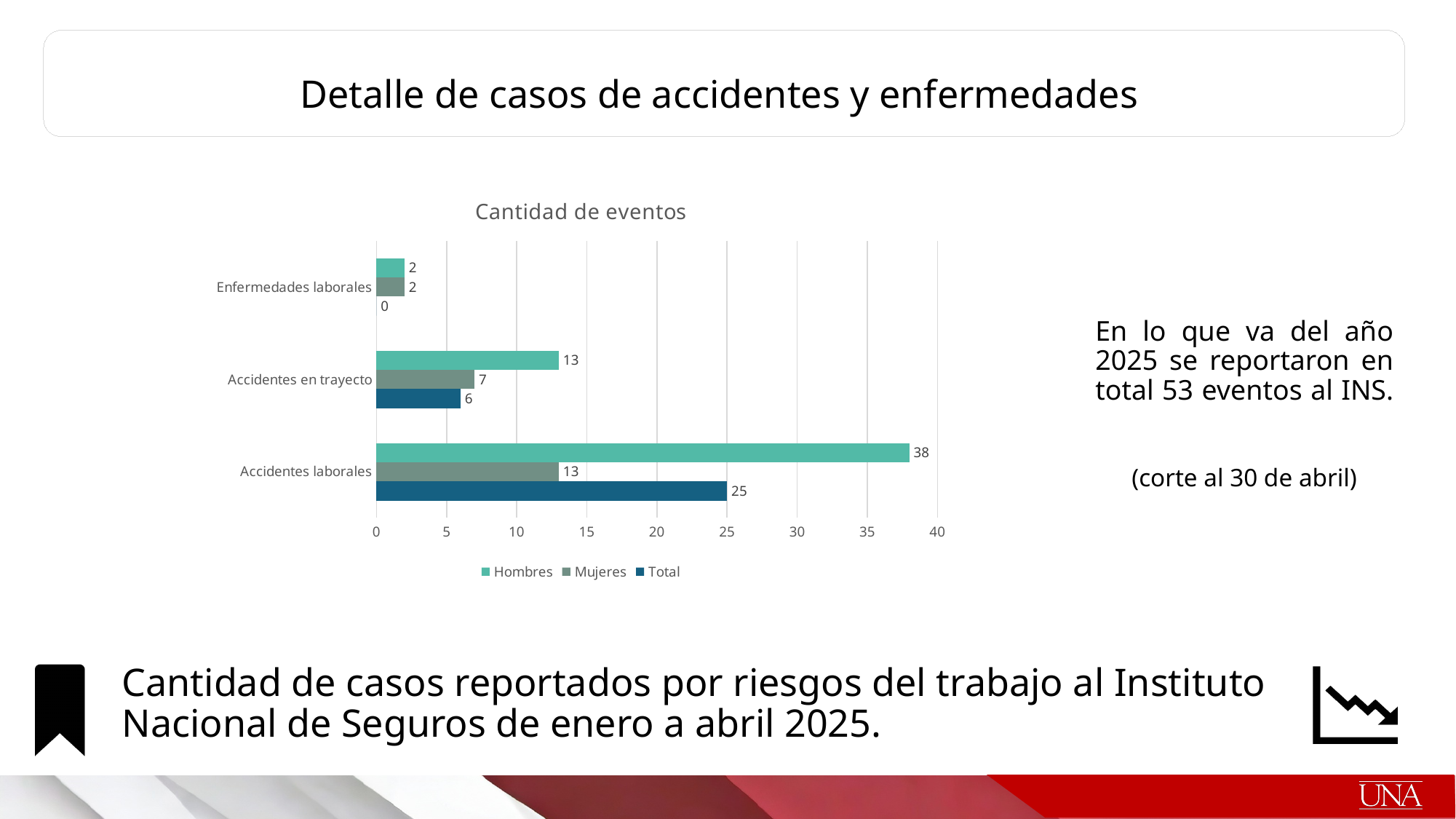
Which category has the highest Hombres value? Accidentes laborales What is the value for Hombres in the Accidentes laborales category? 38 How many categories are shown on the chart? 3 What is the value for Total in the Accidentes laborales category? 25 What is the difference between the Hombres and Mujeres values for Accidentes laborales? 25 How many series does the legend list? 3 What kind of chart is shown on the slide? Bar chart What is the value for Mujeres in the Accidentes en trayecto category? 7 Which is larger for Accidentes en trayecto, the Hombres value or the Total value? Hombres Which category has the lowest Total value? Enfermedades laborales What is the value for Total in the Enfermedades laborales category? 0 What is the title of the chart? Cantidad de eventos